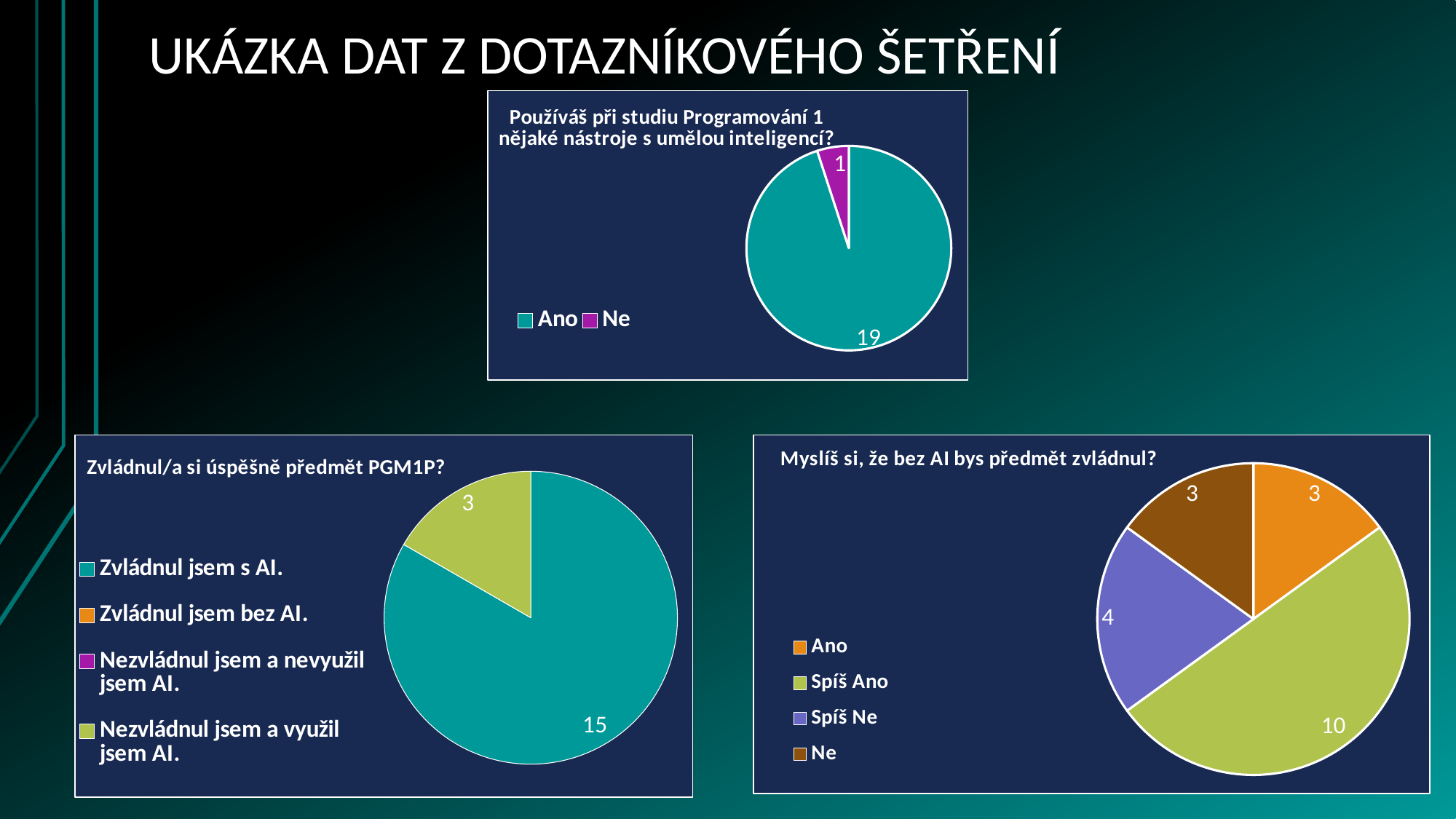
In the chart titled "Myslíš si, že bez AI bys předmět zvládnul?", what is the value for Spíš Ne? 4 In the chart titled "Používáš při studiu Programování 1 nějaké nástroje s umělou inteligencí?", what is the value for Ne? 1 In the chart titled "Zvládnul/a si úspěšně předmět PGM1P?", what is the value for "Zvládnul jsem s AI."? 15 In the chart titled "Myslíš si, že bez AI bys předmět zvládnul?", what share of the pie does Spíš Ano represent? 50% In the chart titled "Myslíš si, že bez AI bys předmět zvládnul?", what colour is the Ne slice? brown In the chart titled "Myslíš si, že bez AI bys předmět zvládnul?", what is the difference between Spíš Ano and Spíš Ne? 6 In the chart titled "Myslíš si, že bez AI bys předmět zvládnul?", which category has the highest value? Spíš Ano How many entries does the legend list in the chart titled "Zvládnul/a si úspěšně předmět PGM1P?"? 4 In the chart titled "Používáš při studiu Programování 1 nějaké nástroje s umělou inteligencí?", what share of the pie does Ano represent? 95% In the chart titled "Používáš při studiu Programování 1 nějaké nástroje s umělou inteligencí?", what is the value for Ano? 19 In the chart titled "Zvládnul/a si úspěšně předmět PGM1P?", what is the value for "Nezvládnul jsem a využil jsem AI."? 3 What kind of chart is the one titled "Zvládnul/a si úspěšně předmět PGM1P?"? pie chart